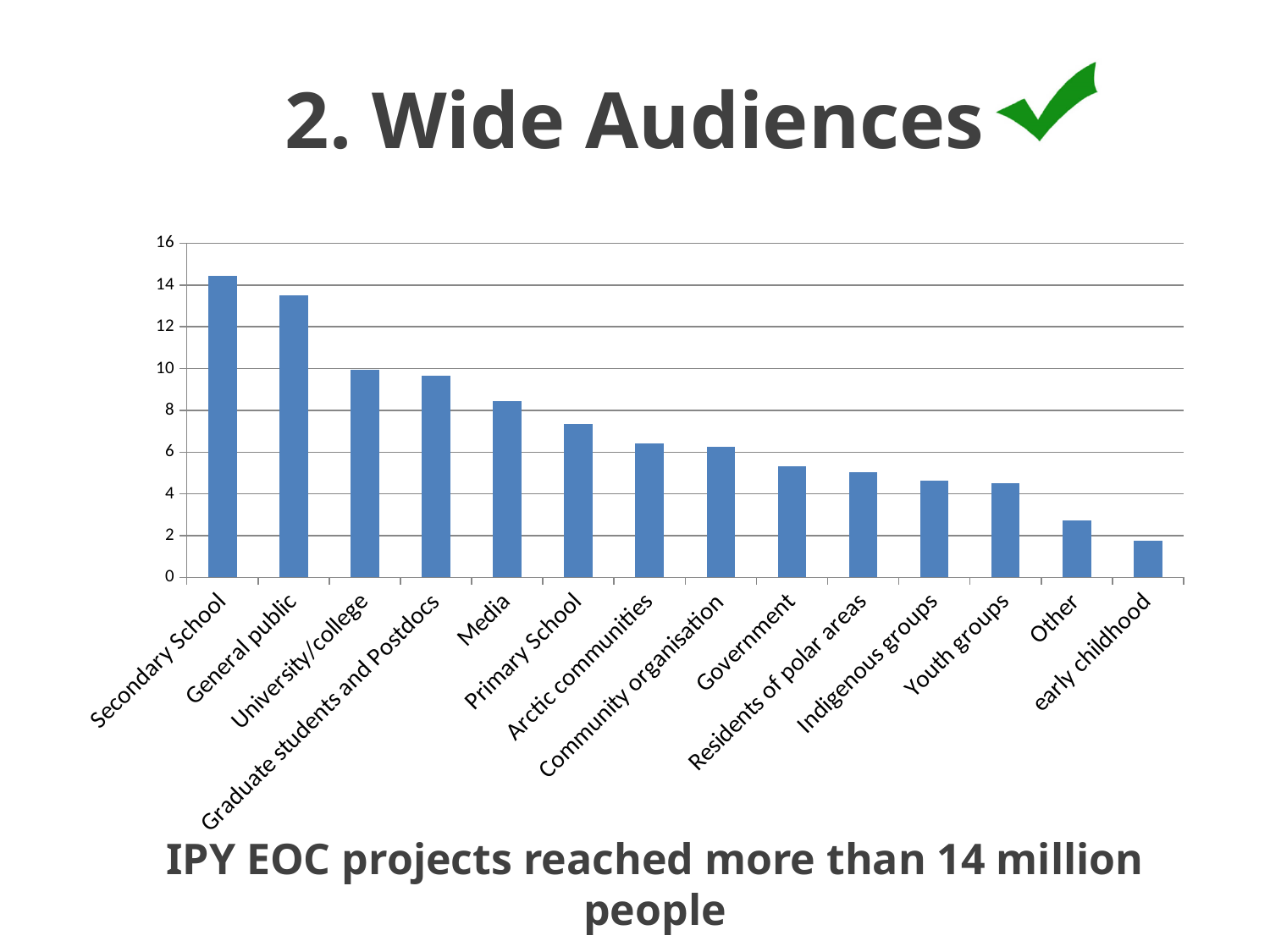
Is the value for General public greater or less than 12? greater Is the value for Other greater or less than 4? less Which audience category has the highest bar in the chart? Secondary School Is the value for Media greater or less than 8? greater Which audience category has the lowest bar in the chart? early childhood Which is larger, the value for Media or the value for Primary School? Media What kind of chart is shown on the slide? bar chart Do the bar values rise or fall from left to right along the x axis? fall Which is larger, the value for Secondary School or the value for General public? Secondary School How many audience categories are shown on the x axis of the chart? 14